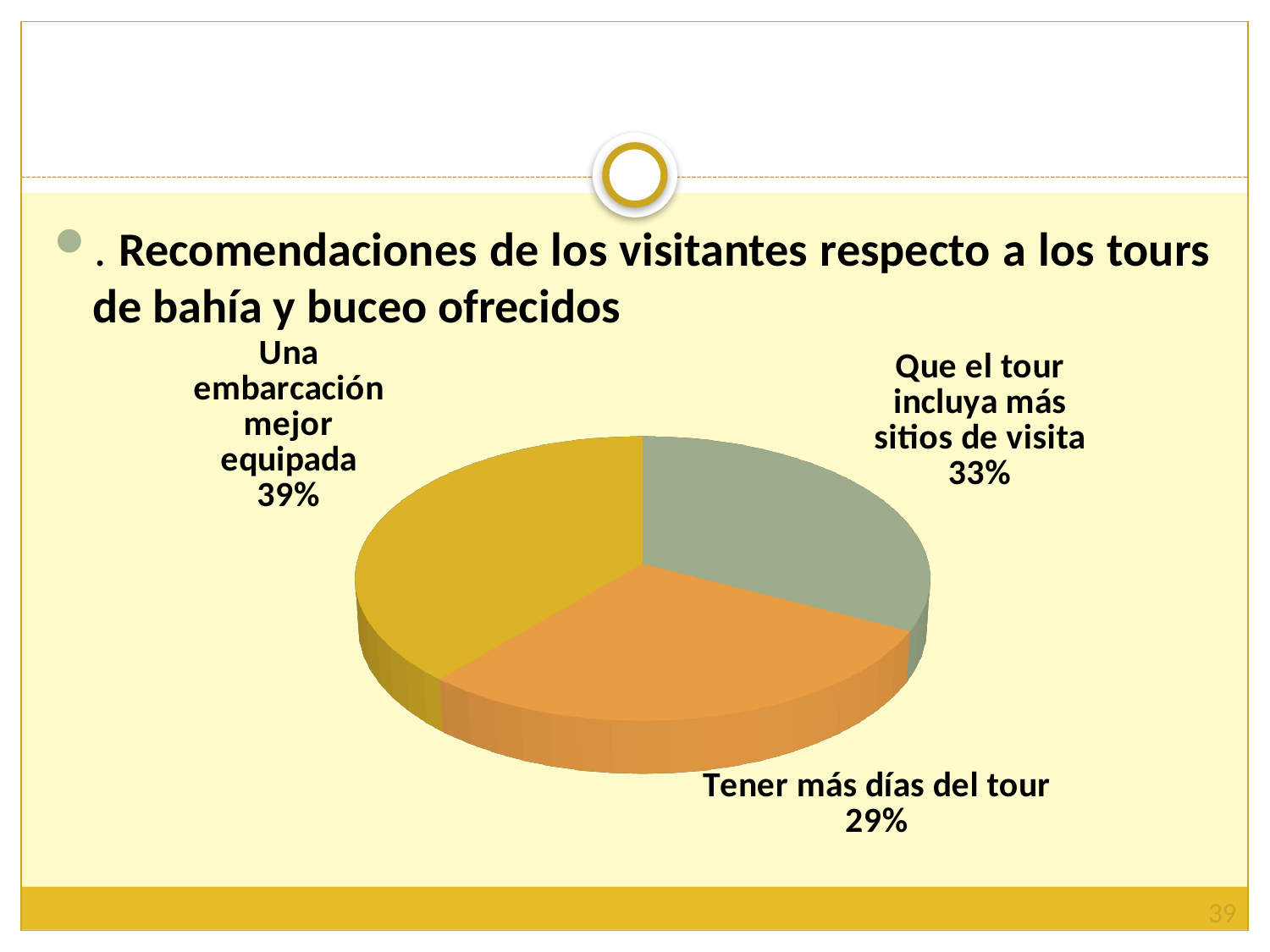
Which recommendation has the smallest share of the pie? Tener más días del tour What is the difference in percentage points between "Que el tour incluya más sitios de visita" and "Tener más días del tour"? 4 What colour is the slice for "Tener más días del tour"? Orange How many slices does the pie chart have? 3 What kind of chart is shown on the slide? Pie chart What share of the pie does "Una embarcación mejor equipada" represent? 39% What colour is the slice for "Una embarcación mejor equipada"? Yellow What is the difference in percentage points between "Una embarcación mejor equipada" and "Tener más días del tour"? 10 What share of the pie does "Tener más días del tour" represent? 29% What share of the pie does "Que el tour incluya más sitios de visita" represent? 33% Which recommendation has the largest share of the pie? Una embarcación mejor equipada Which is larger: the share for "Que el tour incluya más sitios de visita" or the share for "Tener más días del tour"? Que el tour incluya más sitios de visita